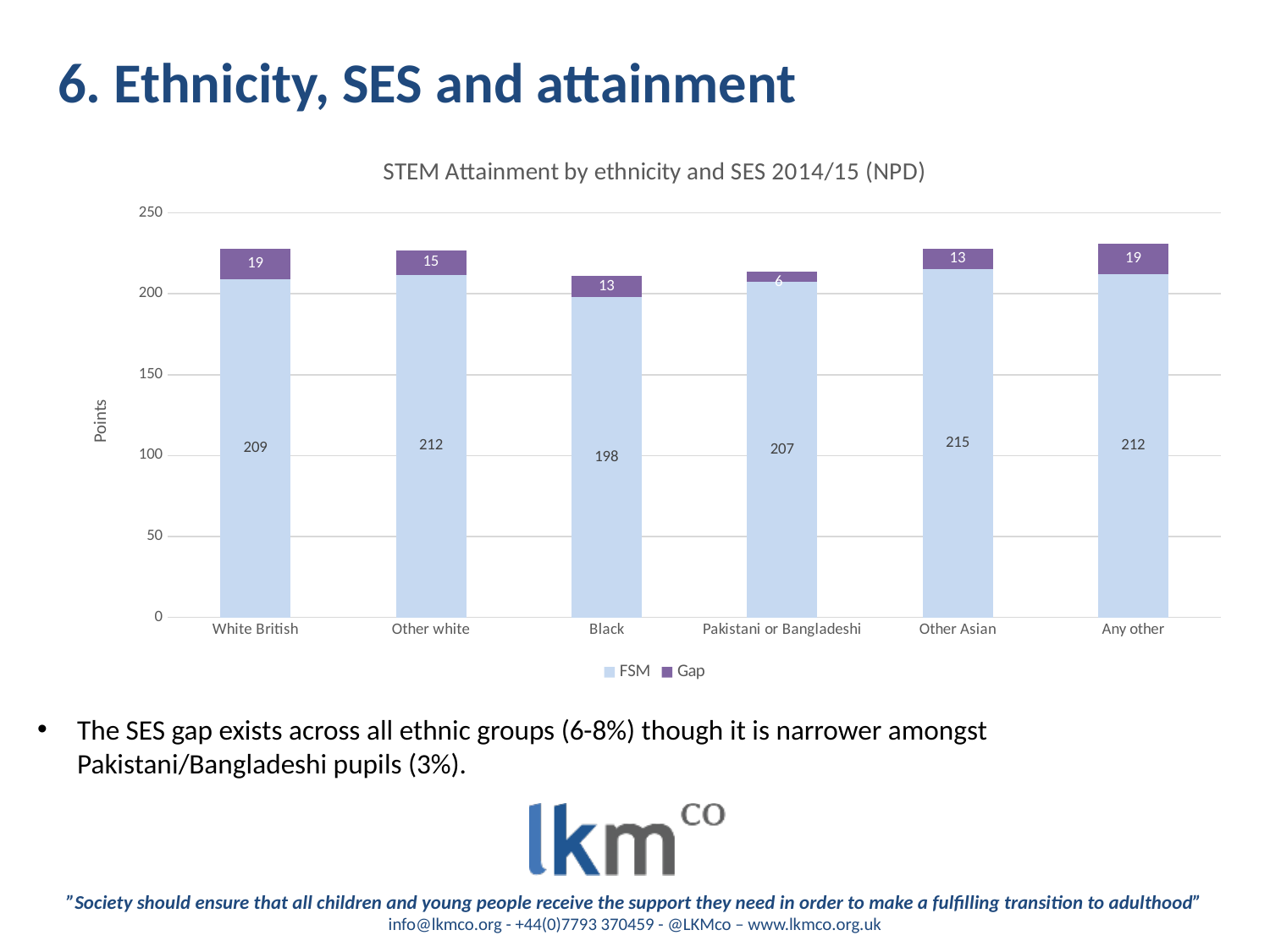
Which is larger, the Gap for White British or the Gap for Other white? White British What is the difference between the FSM values for Other Asian and Black pupils? 17 Which ethnic group has the smallest Gap value? Pakistani or Bangladeshi How many series does the legend list? 2 Which ethnic group has the lowest FSM value? Black What type of chart is shown on the slide? Stacked bar chart What is the total of the stacked bar for Any other? 231 What is the FSM value for Other Asian pupils? 215 Which ethnic group has the highest FSM value? Other Asian How many ethnic groups are shown on the x axis? 6 What is the FSM value for Black pupils? 198 What is the Gap value for Pakistani or Bangladeshi pupils? 6